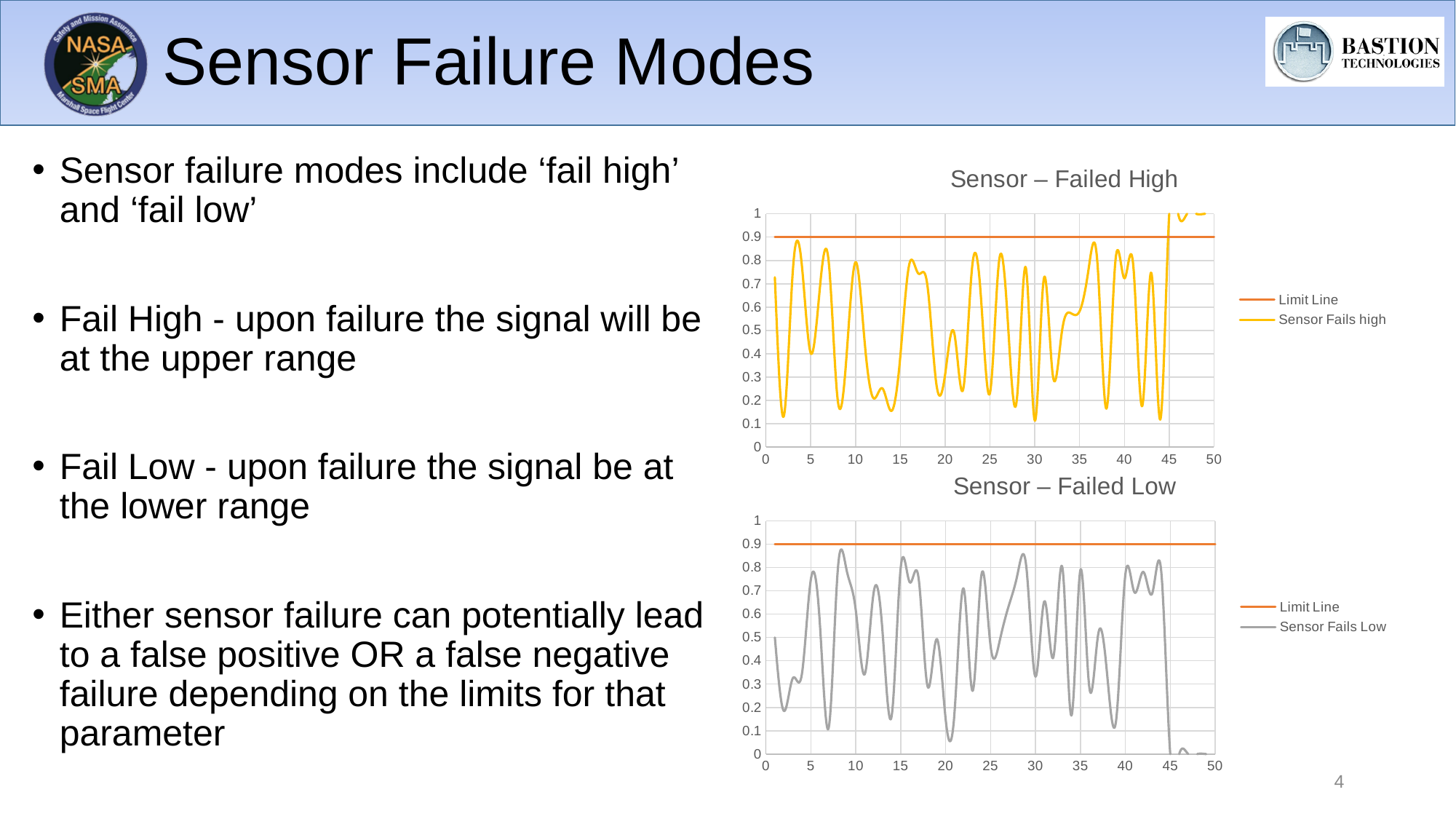
In the 'Sensor – Failed Low' chart, which series is higher at x = 47, Limit Line or Sensor Fails Low? Limit Line In the 'Sensor – Failed Low' chart, is the 'Sensor Fails Low' value at x = 48 greater or less than 0.1? less How many series does the legend of the 'Sensor – Failed Low' chart list? 2 In the 'Sensor – Failed High' chart, what value does the Limit Line sit at? 0.9 What are the two legend entries of the 'Sensor – Failed High' chart? Limit Line, Sensor Fails high In the 'Sensor – Failed High' chart, is the 'Sensor Fails high' value at x = 48 greater or less than 0.9? greater In the 'Sensor – Failed Low' chart, does the 'Sensor Fails Low' series rise or fall between x = 44 and x = 46? fall In the 'Sensor – Failed High' chart, does the 'Sensor Fails high' series rise or fall between x = 44 and x = 46? rise In the 'Sensor – Failed High' chart, which series is higher at x = 48, Limit Line or Sensor Fails high? Sensor Fails high In the 'Sensor – Failed Low' chart, what value does the Limit Line sit at? 0.9 What colour is the 'Sensor Fails Low' line in the 'Sensor – Failed Low' chart? grey What kind of chart is the 'Sensor – Failed High' chart? line chart